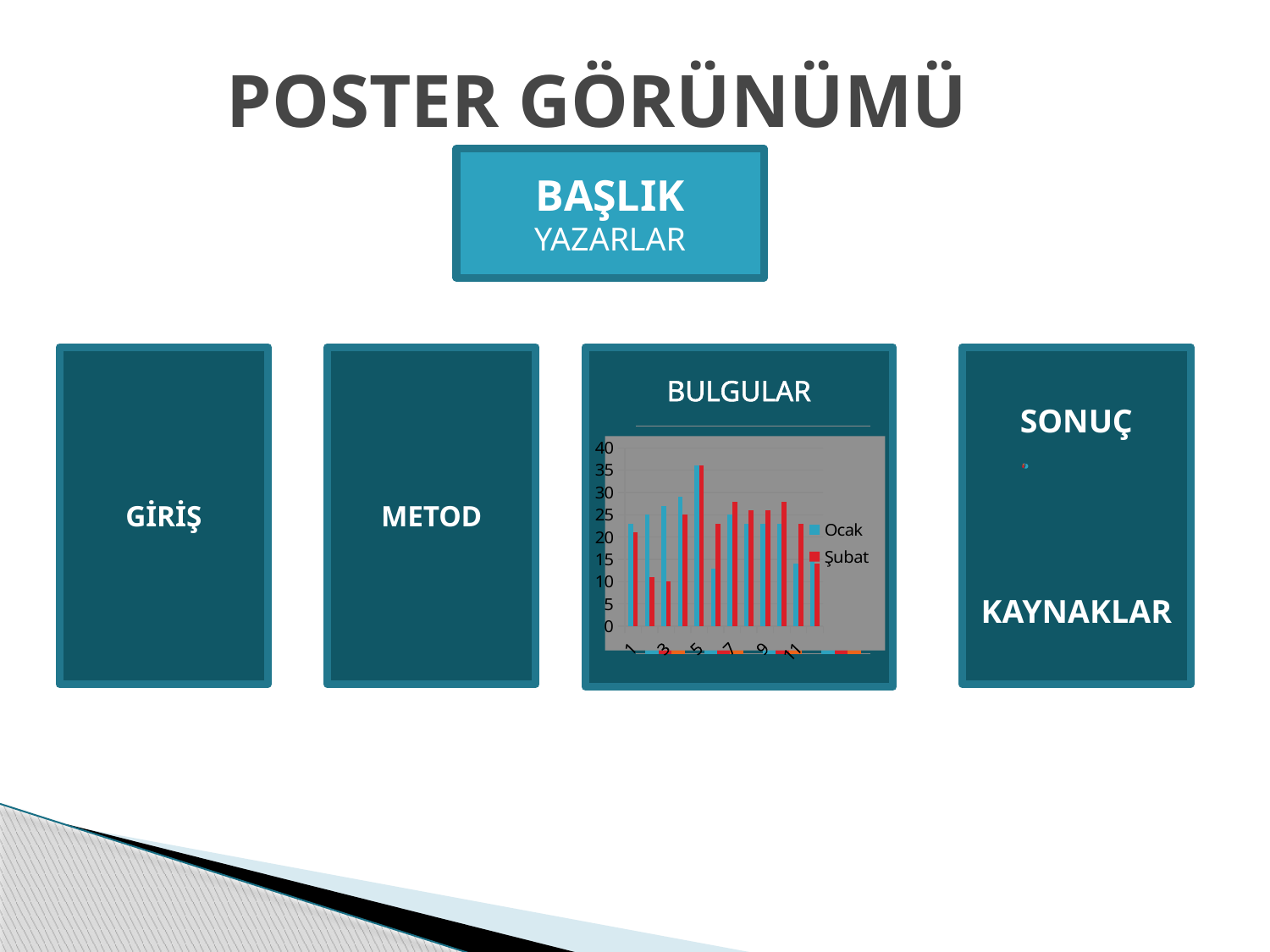
What kind of chart is shown in the BULGULAR panel? bar chart In the BULGULAR chart, is the Şubat value for category 3 greater or less than 15? less In the BULGULAR chart, which category has the highest Şubat value? 5 How many series does the legend of the BULGULAR chart list? 2 In the BULGULAR chart, which category has the highest Ocak value? 5 In the BULGULAR chart, is the Ocak value for category 5 greater or less than 30? greater In the BULGULAR chart, which colour represents the Şubat series? red In the BULGULAR chart, which is larger for category 3, the Ocak value or the Şubat value? Ocak What are the two series named in the legend of the BULGULAR chart? Ocak and Şubat In the BULGULAR chart, is the Şubat value for category 5 greater or less than 30? greater